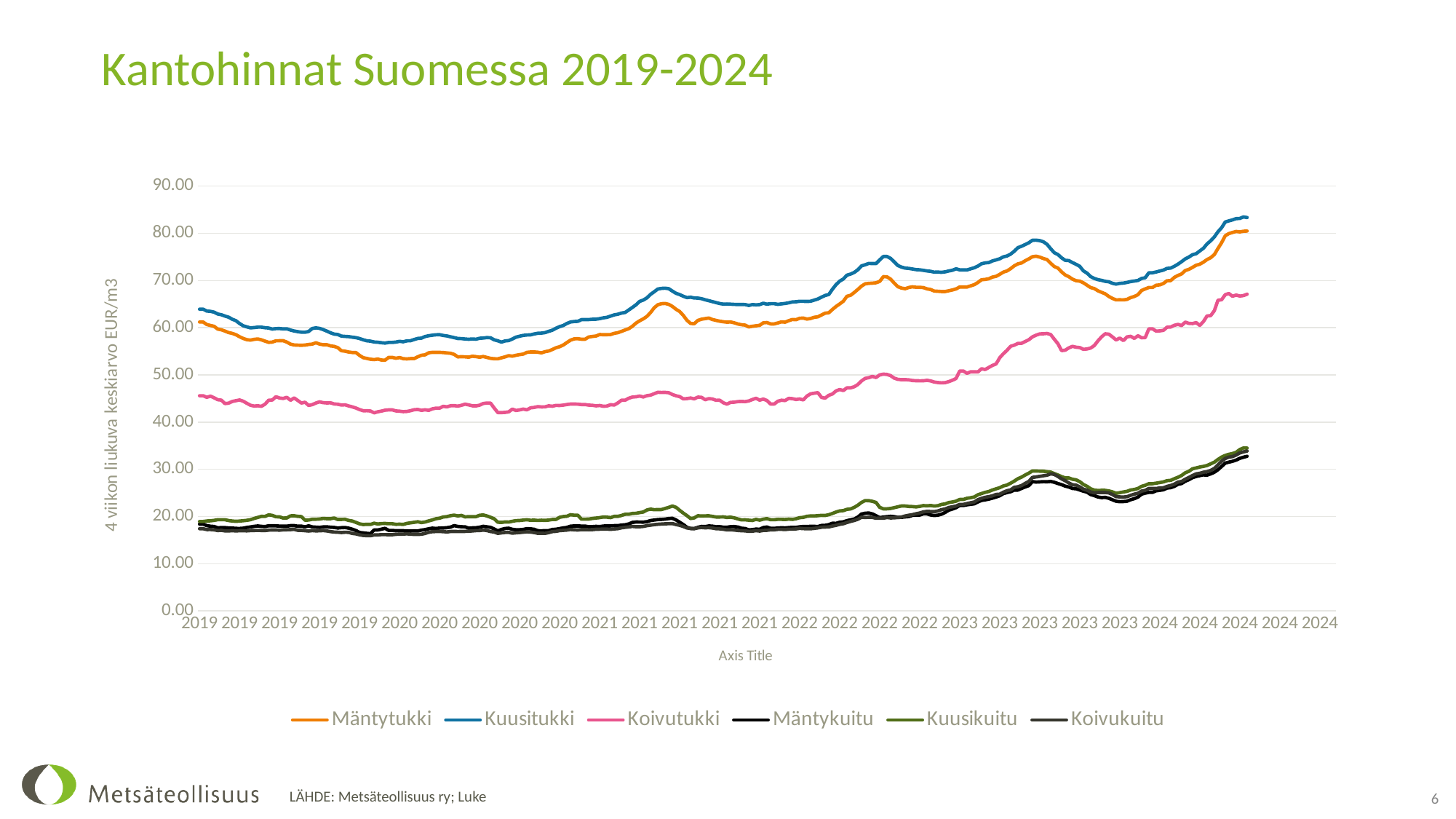
Which series has the highest values throughout the chart? Kuusitukki Is the value for Kuusitukki at the end of 2024 greater or less than 80? greater How many series does the legend list? 6 Is the value for Mäntykuitu at the start of 2019 greater or less than 20? less What kind of chart is shown on the slide? line chart Is the value for Mäntytukki at the start of 2019 greater or less than 70? less Do the Koivutukki values rise or fall overall from 2019 to 2024? rise What is the title of the vertical axis? 4 viikon liukuva keskiarvo EUR/m3 At the end of 2024, which is higher, Kuusitukki or Mäntytukki? Kuusitukki Which is higher throughout the chart, Mäntytukki or Koivutukki? Mäntytukki